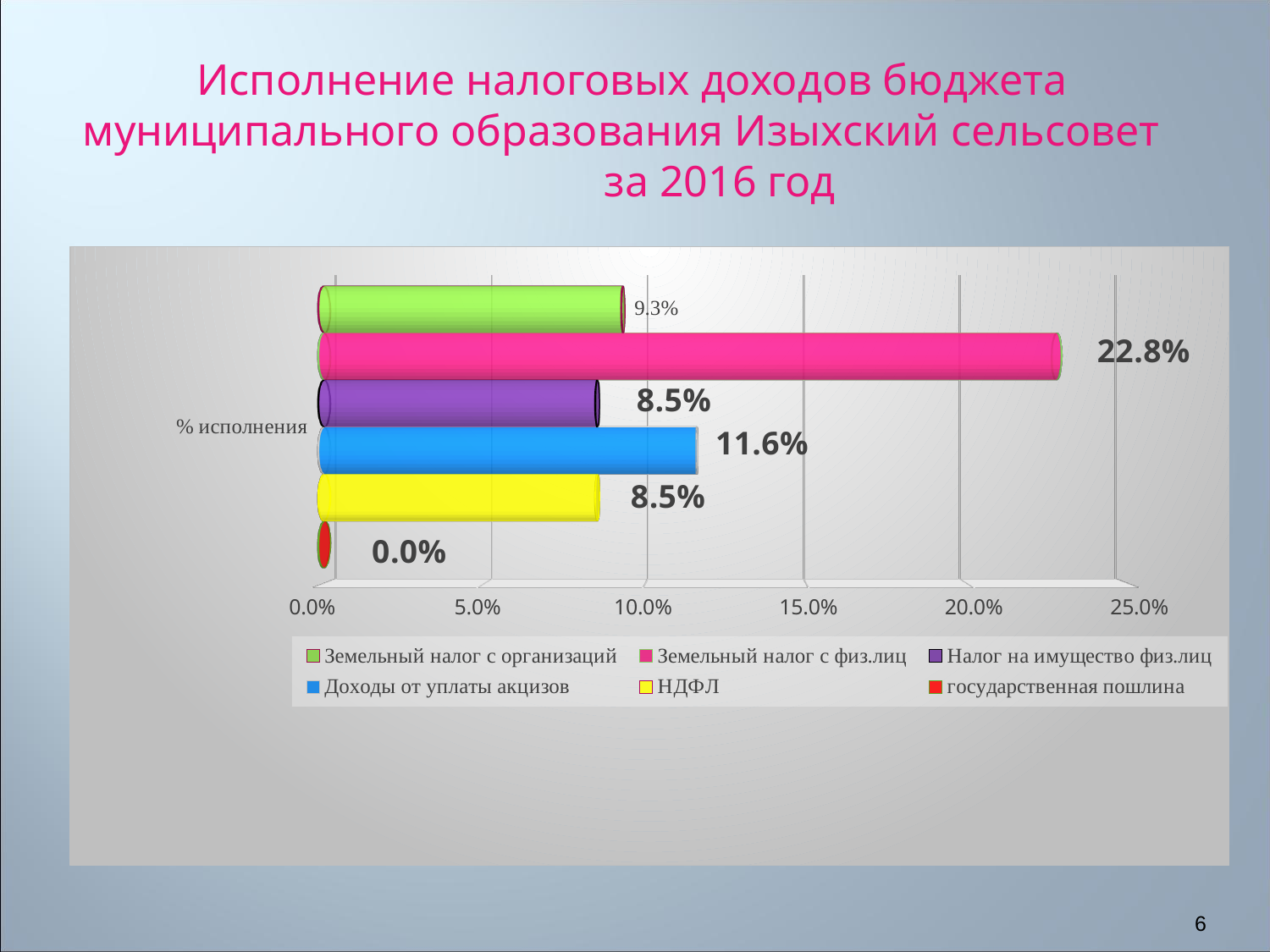
What kind of chart is shown on the slide? bar chart Which series has the highest value? Земельный налог с физ.лиц What colour is the bar for НДФЛ? yellow What is the difference between the values for Земельный налог с физ.лиц and Доходы от уплаты акцизов? 11.2% Is the value for Земельный налог с физ.лиц greater or less than 20.0%? greater What is the value for Доходы от уплаты акцизов? 11.6% What is the value for Земельный налог с организаций? 9.3% What is the value for государственная пошлина? 0.0% Which series has the lowest value? государственная пошлина What is the value for Земельный налог с физ.лиц? 22.8% How many series does the legend list? 6 Which is larger, the value for Земельный налог с организаций or the value for НДФЛ? Земельный налог с организаций